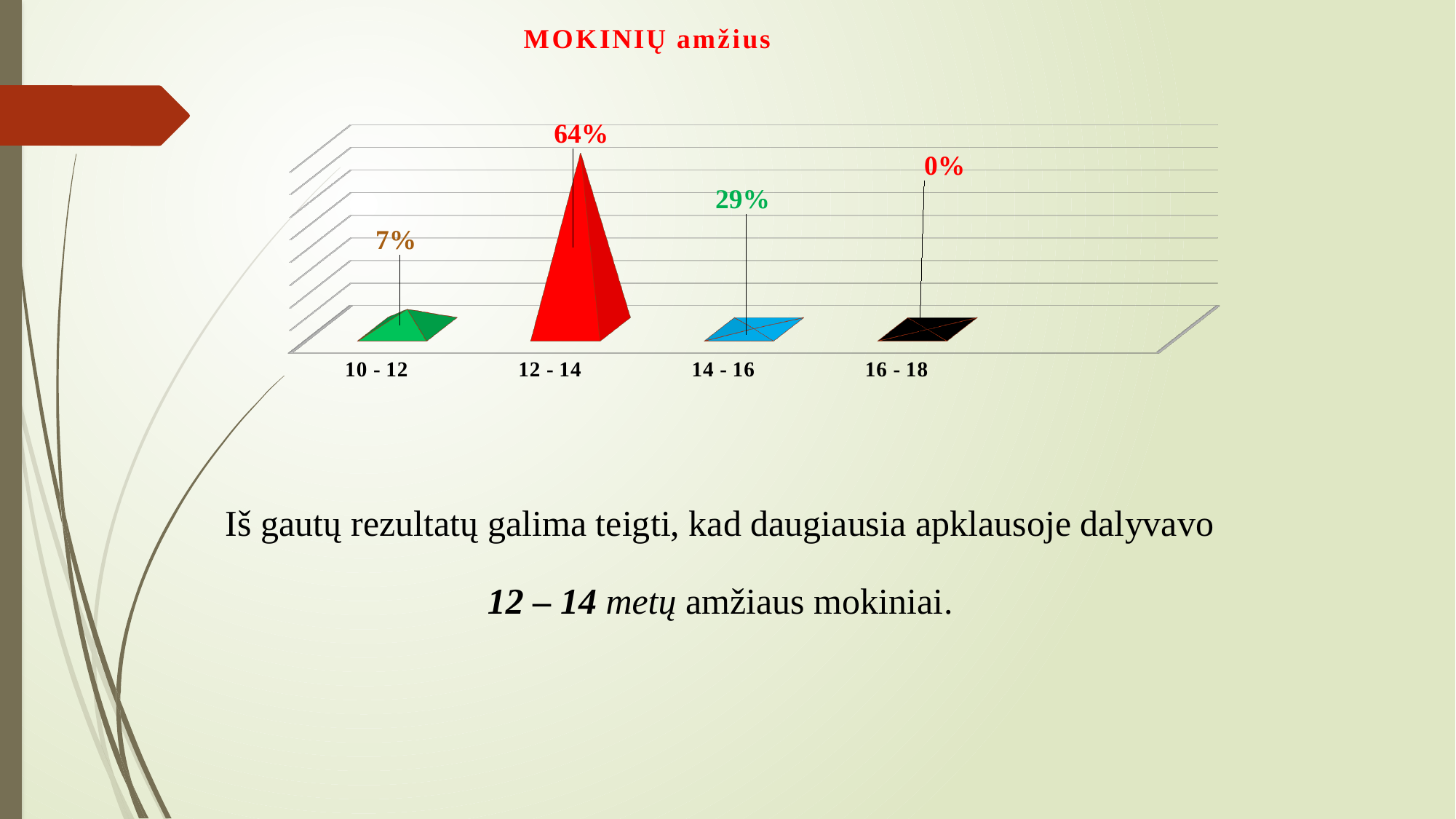
What is the value for the 14 - 16 age group? 29% What is the difference between the values for 14 - 16 and 10 - 12? 22% Which age group has the highest value? 12 - 14 What is the value for the 16 - 18 age group? 0% How many age groups are shown on the chart? 4 What is the difference between the values for 12 - 14 and 14 - 16? 35% Which age group has the lowest value? 16 - 18 What is the value for the 12 - 14 age group? 64% What is the value for the 10 - 12 age group? 7% What is the title of the chart? MOKINIŲ amžius What kind of chart is shown on the slide? bar chart Which is larger, the value for 10 - 12 or the value for 14 - 16? 14 - 16